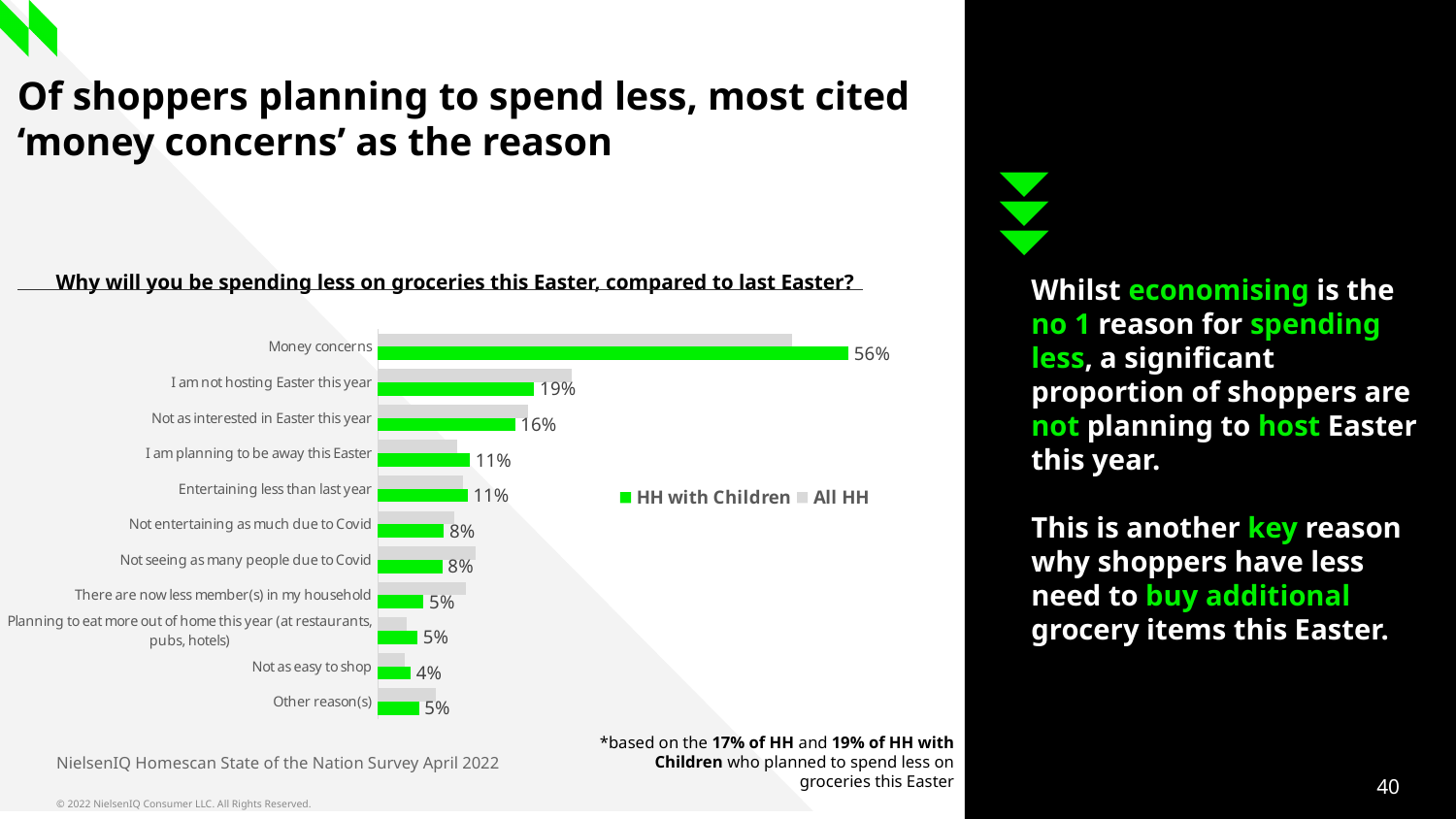
How many series does the legend list? 2 How many reasons (categories) are listed in the chart? 11 Which reason has the lowest value for HH with Children? Not as easy to shop Which reason has the highest value for HH with Children? Money concerns For HH with Children, which is larger: 'Not as interested in Easter this year' or 'I am planning to be away this Easter'? Not as interested in Easter this year What is the value for 'Not as interested in Easter this year' for HH with Children? 16% What type of chart is shown on the slide? bar chart Which series is shown in green in the chart? HH with Children What is the value for 'Money concerns' for the HH with Children series? 56% What is the difference between the HH with Children values for 'Money concerns' and 'I am not hosting Easter this year'? 37% What is the value for 'Not as easy to shop' for HH with Children? 4% What is the value for 'I am not hosting Easter this year' for HH with Children? 19%